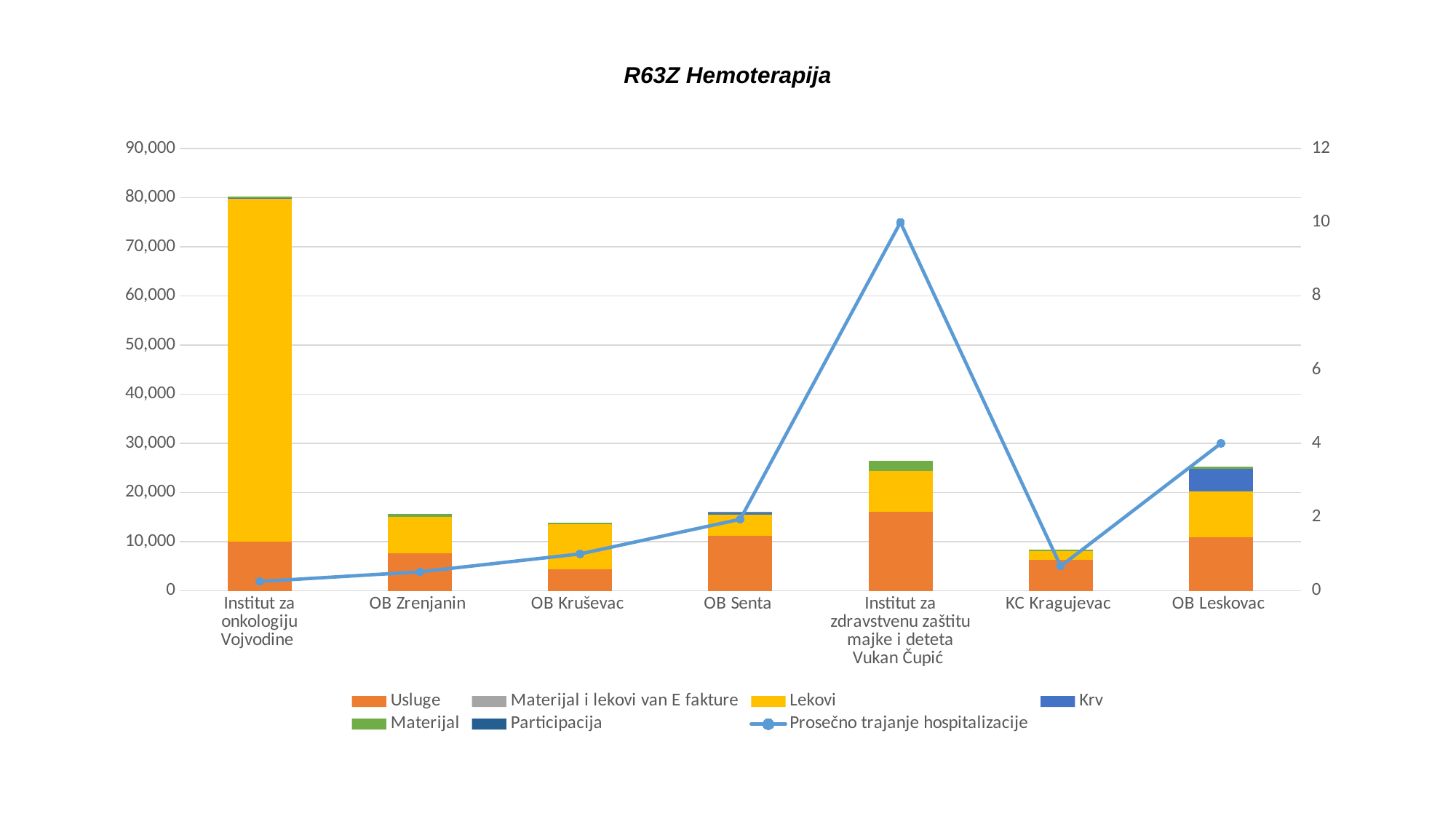
Which has the larger total stacked bar, Institut za zdravstvenu zaštitu majke i deteta Vukan Čupić or OB Zrenjanin? Institut za zdravstvenu zaštitu majke i deteta Vukan Čupić Is the total stacked bar for KC Kragujevac greater or less than 10,000? less How many categories (institutions) are shown on the x axis? 7 Which institution has the highest value on the Prosečno trajanje hospitalizacije line? Institut za zdravstvenu zaštitu majke i deteta Vukan Čupić How many series does the legend list? 7 Which institution has the shortest stacked bar? KC Kragujevac Which institution has the tallest stacked bar? Institut za onkologiju Vojvodine Is the Prosečno trajanje hospitalizacije value for Institut za zdravstvenu zaštitu majke i deteta Vukan Čupić greater or less than 8? greater What kind of chart is this? Stacked bar chart combined with a line Which series is shown in yellow in the legend? Lekovi Is the total stacked bar for Institut za onkologiju Vojvodine greater or less than 70,000? greater What is the title of the chart? R63Z Hemoterapija